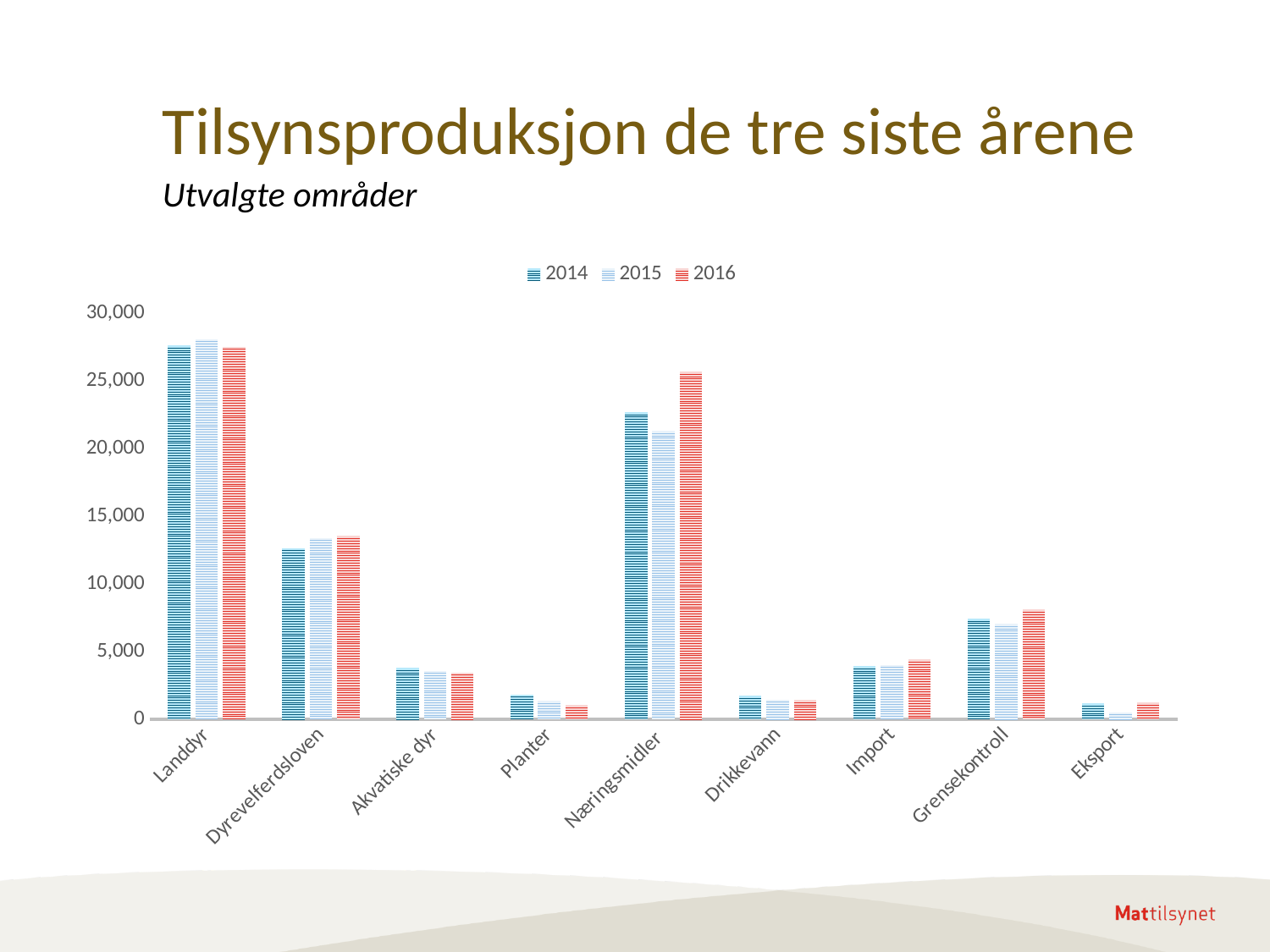
Is the value for Landdyr in 2014 greater or less than 25,000? greater How many series does the legend list? 3 Is the value for Dyrevelferdsloven in 2014 greater or less than 15,000? less For Næringsmidler, which is larger: the 2015 value or the 2016 value? 2016 Do the values for Planter rise or fall from 2014 to 2016? fall Which category has the highest value for 2016? Landdyr How many categories are shown on the x axis? 9 For 2014, which is larger: Landdyr or Næringsmidler? Landdyr What kind of chart is shown on the slide? bar chart Which category has the lowest value for 2015? Eksport Is the value for Næringsmidler in 2016 greater or less than 20,000? greater What are the three entries in the chart legend? 2014, 2015, 2016